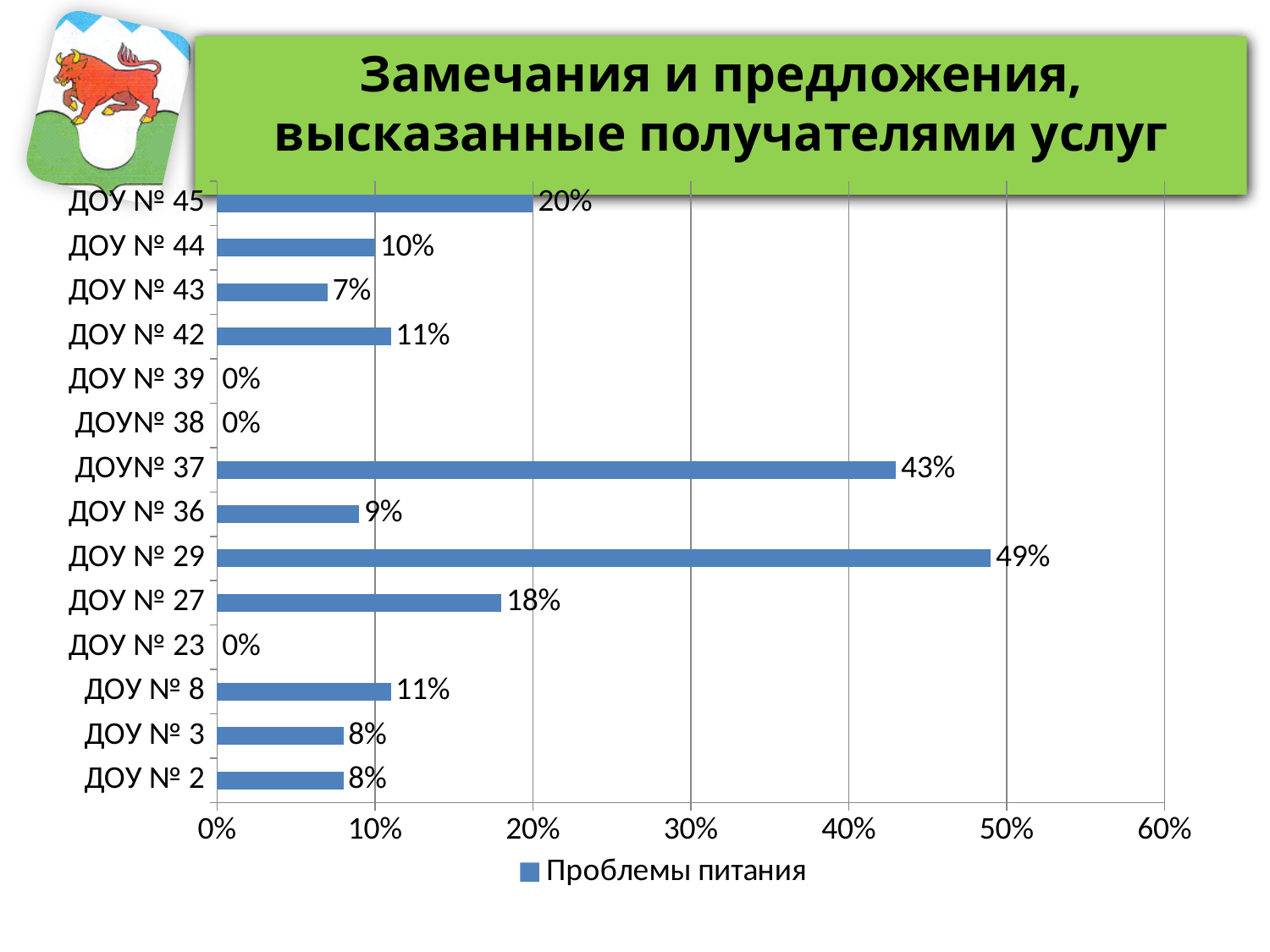
What is the difference between the values for ДОУ № 29 and ДОУ № 37? 6% Which is larger, the value for ДОУ № 42 or the value for ДОУ № 43? ДОУ № 42 What series name does the legend show? Проблемы питания What is the value for ДОУ № 37? 43% How many categories have a value of 0%? 3 What is the value for ДОУ № 27? 18% Which category has the highest value? ДОУ № 29 What kind of chart is shown on the slide? bar chart Is the value for ДОУ № 29 greater or less than 40%? greater How many categories are shown on the chart? 14 What is the value for ДОУ № 45? 20% What is the difference between the values for ДОУ № 45 and ДОУ № 44? 10%